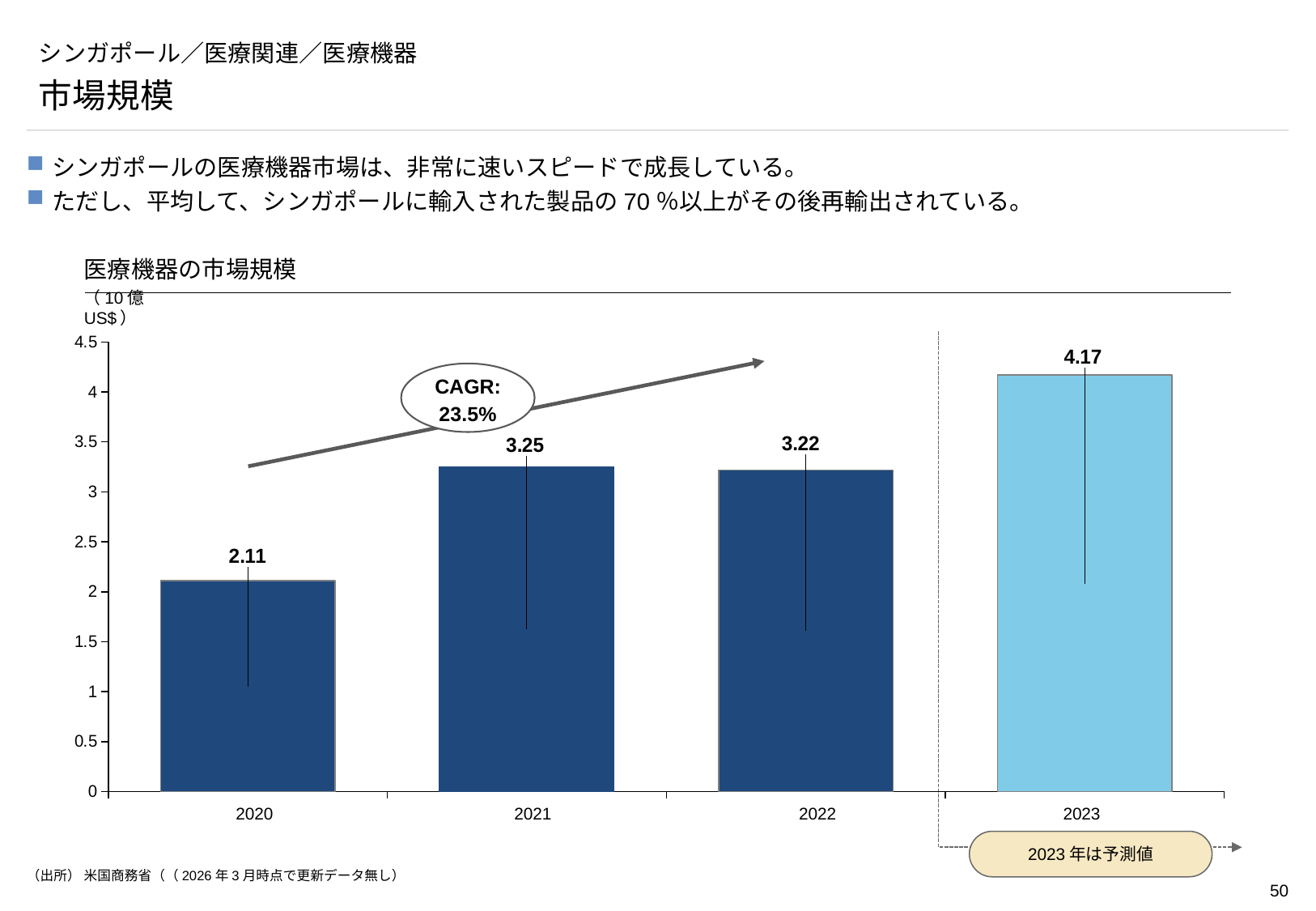
What is the value for 2020 in the 医療機器の市場規模 chart? 2.11 What is the value for 2023 in the 医療機器の市場規模 chart? 4.17 What is the value for 2022 in the 医療機器の市場規模 chart? 3.22 What CAGR is shown in the 医療機器の市場規模 chart? 23.5% What is the difference between the 2021 and 2022 values in the 医療機器の市場規模 chart? 0.03 What kind of chart is the 医療機器の市場規模 chart? bar chart How many years are shown on the x axis of the 医療機器の市場規模 chart? 4 Which is larger in the 医療機器の市場規模 chart, the value for 2021 or the value for 2020? 2021 Which year has the highest value in the 医療機器の市場規模 chart? 2023 What is the value for 2021 in the 医療機器の市場規模 chart? 3.25 What is the difference between the 2023 and 2020 values in the 医療機器の市場規模 chart? 2.06 Which year has the lowest value in the 医療機器の市場規模 chart? 2020